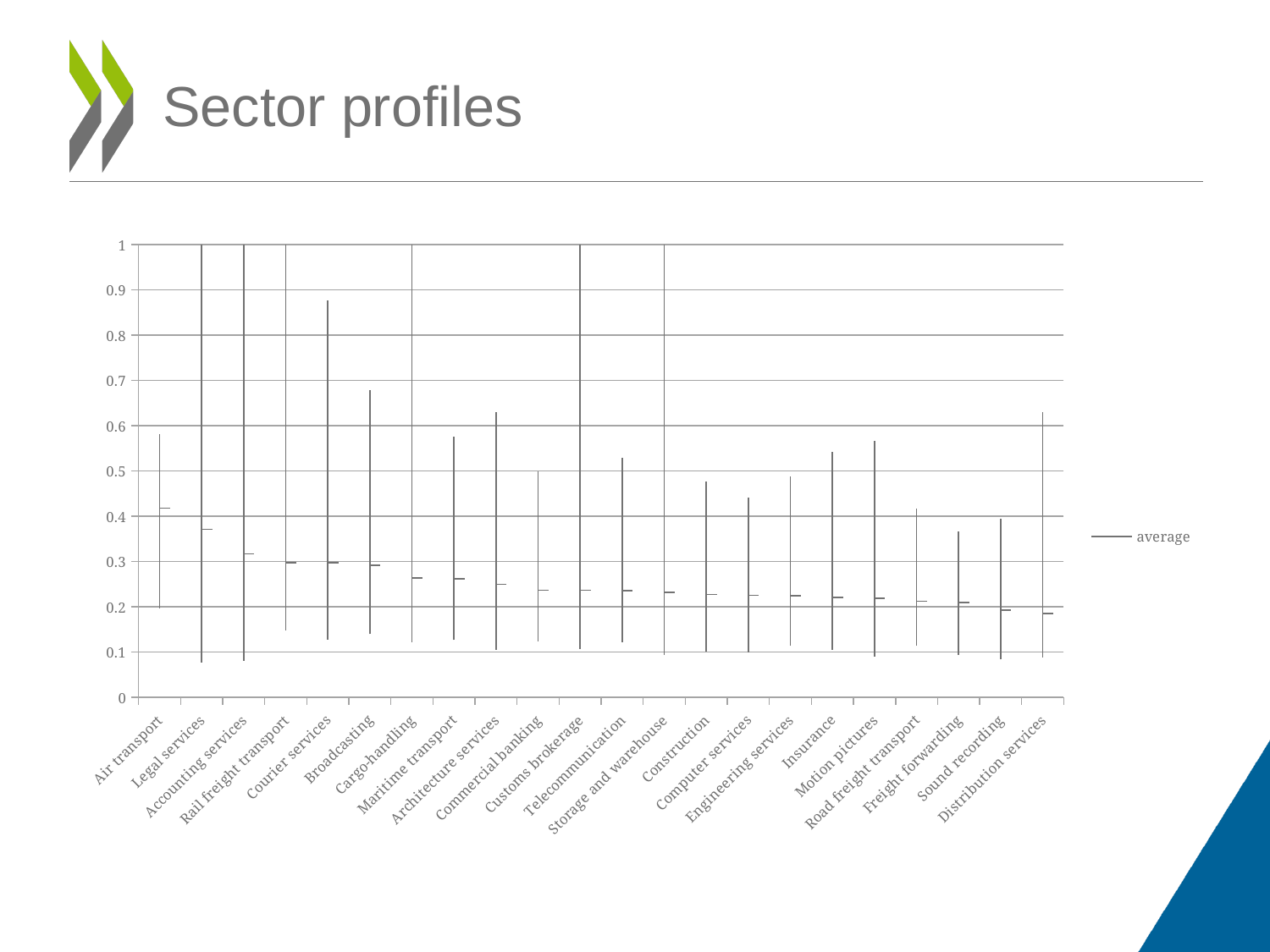
What is the name of the series shown in the chart's legend? average Do the average values rise or fall moving from left to right along the x axis? fall Is the average value for Construction greater or less than 0.3? less What is the title of the slide containing the chart? Sector profiles Is the top of the range line for Courier services greater or less than 0.8? greater Which sector has the highest average value? Air transport Is the average value for Legal services greater or less than 0.4? less How many series does the chart's legend list? 1 Which has the larger average value, Courier services or Construction? Courier services How many sectors are shown along the x axis of the chart? 22